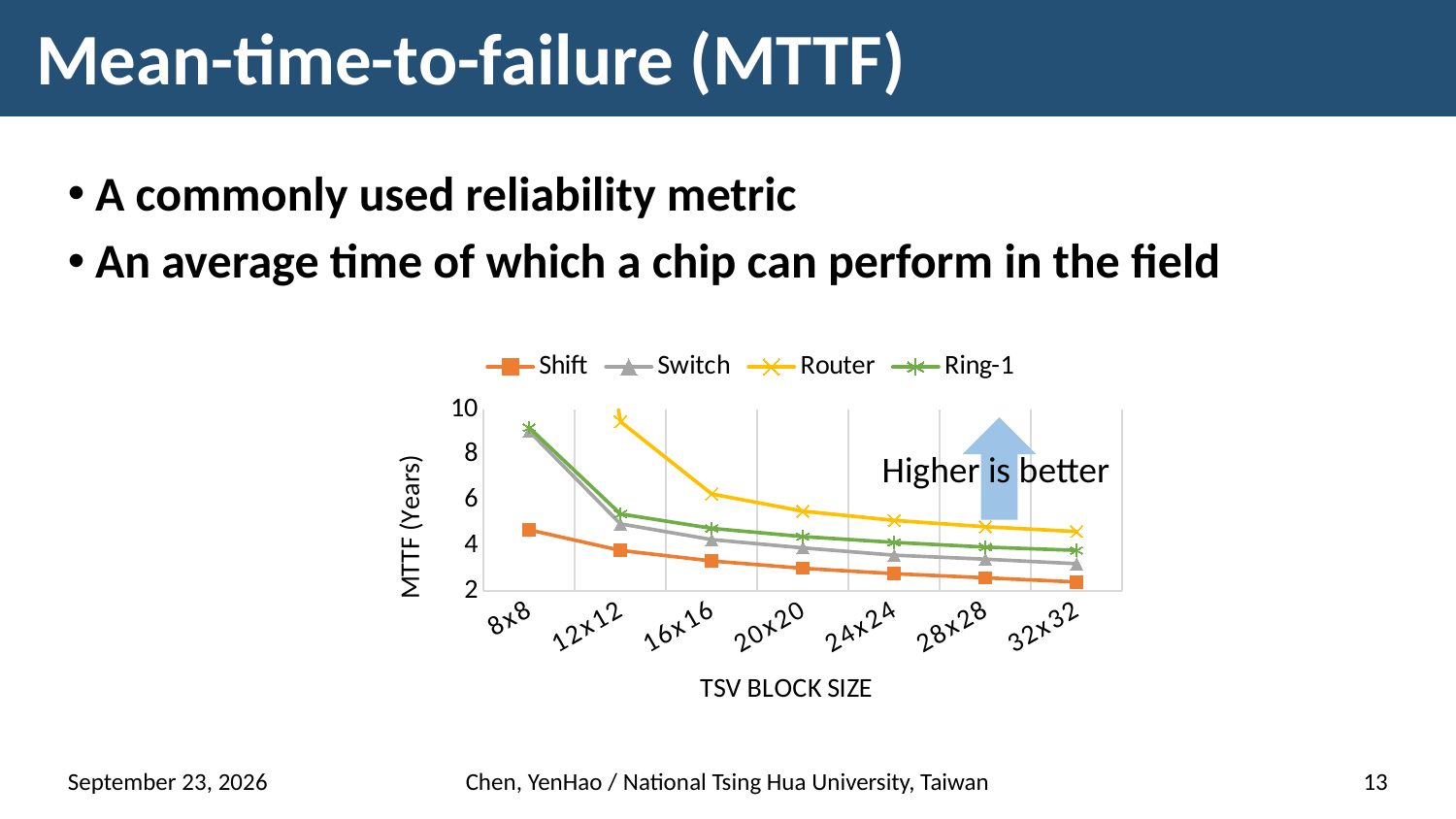
Do the MTTF values rise or fall as the TSV block size increases? fall At the 24x24 block size, which has a larger MTTF, Ring-1 or Switch? Ring-1 What kind of chart is shown on the slide? line chart Is the MTTF value for Router at 12x12 greater or less than 8? greater How many series does the legend list? 4 Which series has the highest MTTF at the 32x32 block size? Router Is the MTTF value for Switch at 32x32 greater or less than 4? less What is the label of the y axis? MTTF (Years) Which series has the lowest MTTF at the 32x32 block size? Shift Is the MTTF value for Shift at 8x8 greater or less than 4? greater At the 20x20 block size, which has a larger MTTF, Router or Shift? Router How many TSV block size categories are shown on the x axis? 7